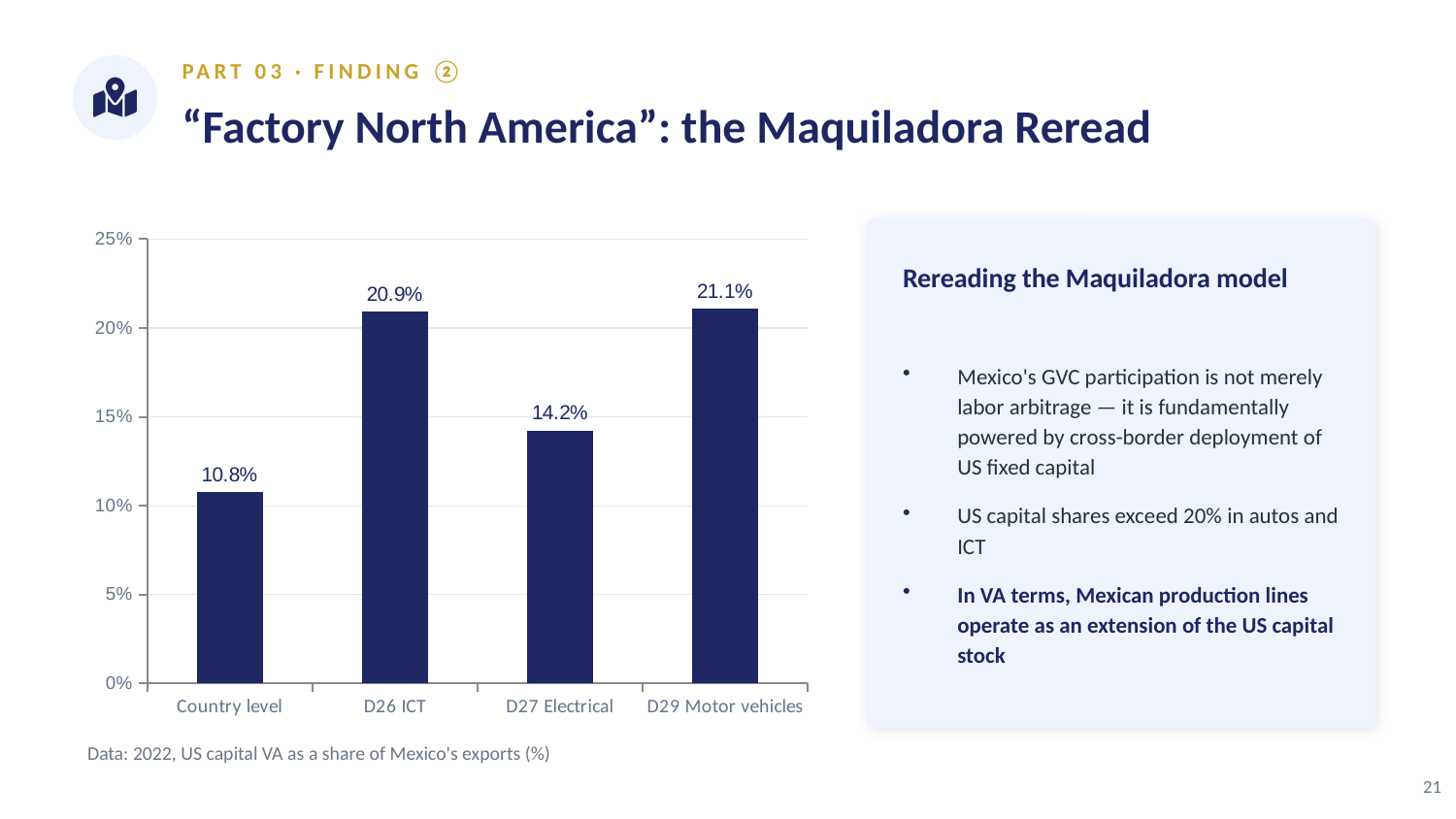
What is the value for Country level? 10.8% What is the difference between the values for D26 ICT and D27 Electrical? 6.7% What is the value for D27 Electrical? 14.2% What is the value for D29 Motor vehicles? 21.1% Is the value for D27 Electrical greater or less than 15%? less What kind of chart is shown on the slide? bar chart What is the value for D26 ICT? 20.9% Which is larger, the value for D26 ICT or the value for D27 Electrical? D26 ICT Which category has the lowest value? Country level How many categories are shown on the x axis? 4 What is the difference between the values for D29 Motor vehicles and Country level? 10.3% Which category has the highest value? D29 Motor vehicles